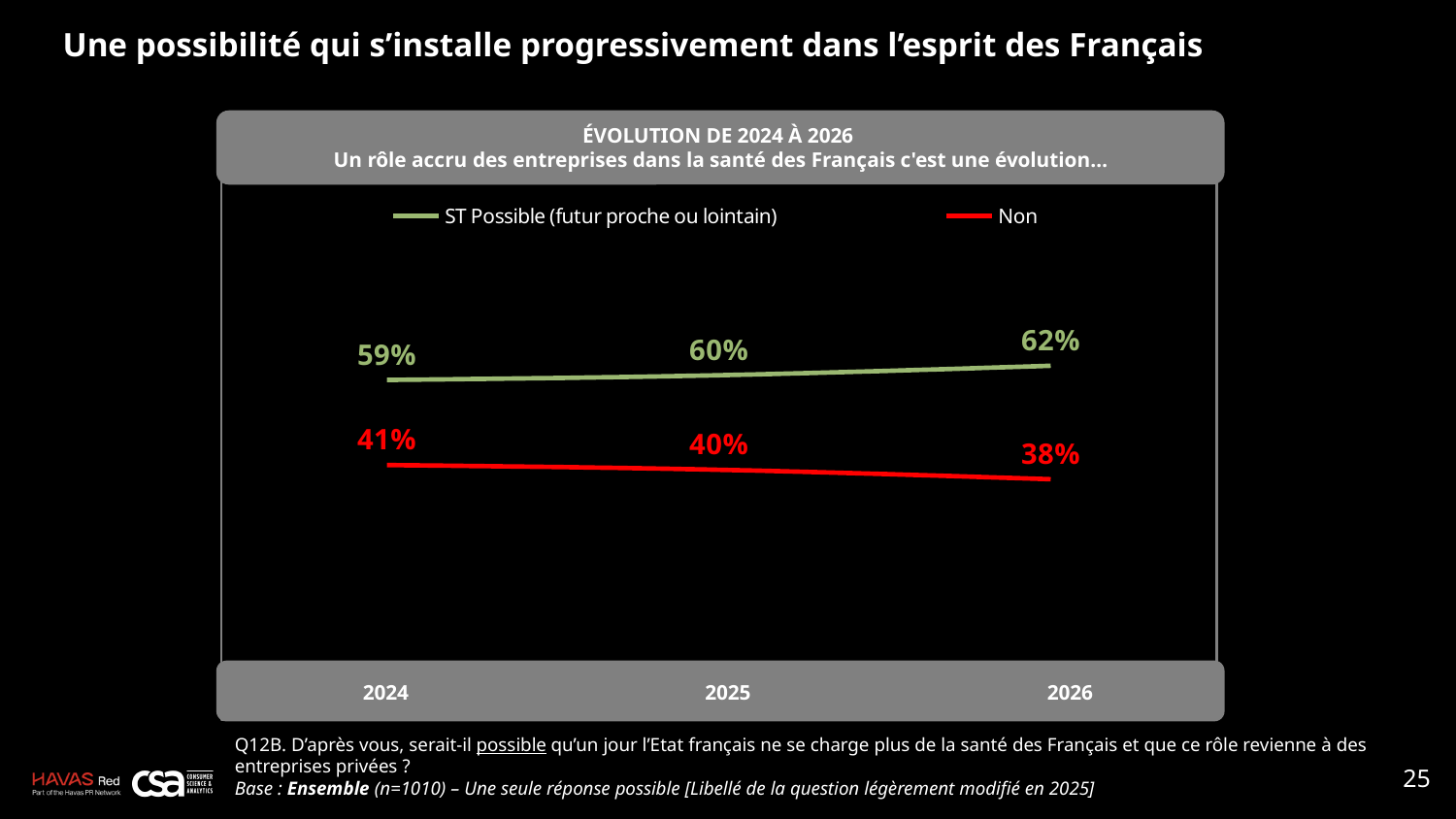
Does the "Non" series rise or fall from 2024 to 2026? Fall Which is larger in 2024: the "ST Possible (futur proche ou lointain)" value or the "Non" value? ST Possible (futur proche ou lointain) How many years are shown on the x axis? 3 What is the value for "ST Possible (futur proche ou lointain)" in 2025? 60% What is the difference between the "ST Possible (futur proche ou lointain)" value and the "Non" value in 2026? 24 percentage points In which year is the "Non" series lowest? 2026 What is the value for "Non" in 2025? 40% In which year is the "ST Possible (futur proche ou lointain)" series highest? 2026 How many series does the legend list? 2 What kind of chart is shown? Line chart What is the value for "ST Possible (futur proche ou lointain)" in 2024? 59% What is the value for "Non" in 2026? 38%